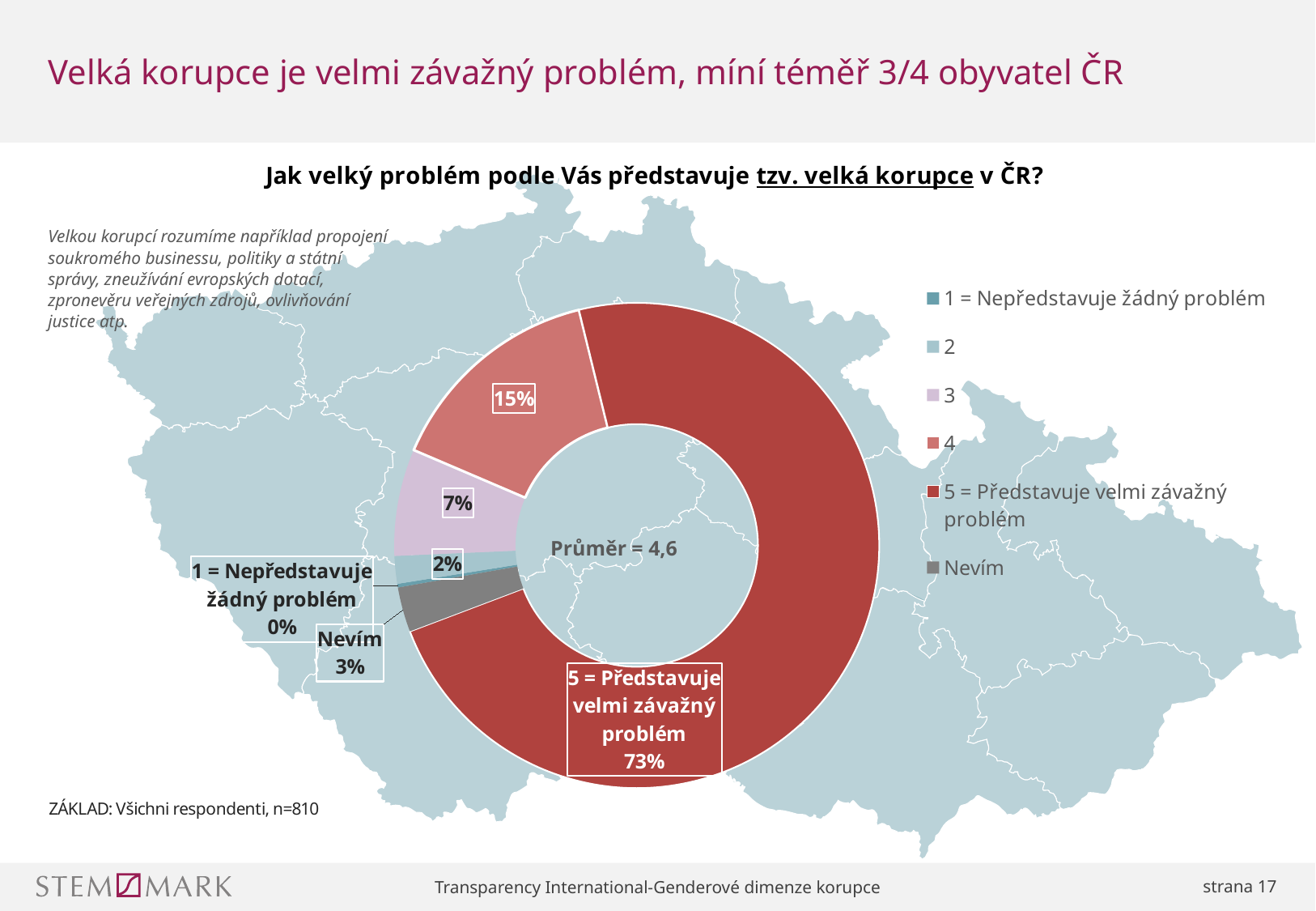
What type of chart is shown on the slide? Doughnut chart What percentage of respondents answered "Nevím"? 3% What percentage of respondents chose category 3? 7% What percentage of respondents chose "1 = Nepředstavuje žádný problém"? 0% How many entries does the chart legend list? 6 What is the difference in percentage points between category 4 and category 3? 8 What percentage of respondents chose category 4? 15% What average value (Průměr) is shown in the centre of the chart? 4,6 What percentage of respondents chose "5 = Představuje velmi závažný problém"? 73% Which category has the smallest share of the doughnut chart? 1 = Nepředstavuje žádný problém Which is larger, the share for category 2 or the share for "Nevím"? Nevím Which category has the largest share of the doughnut chart? 5 = Představuje velmi závažný problém